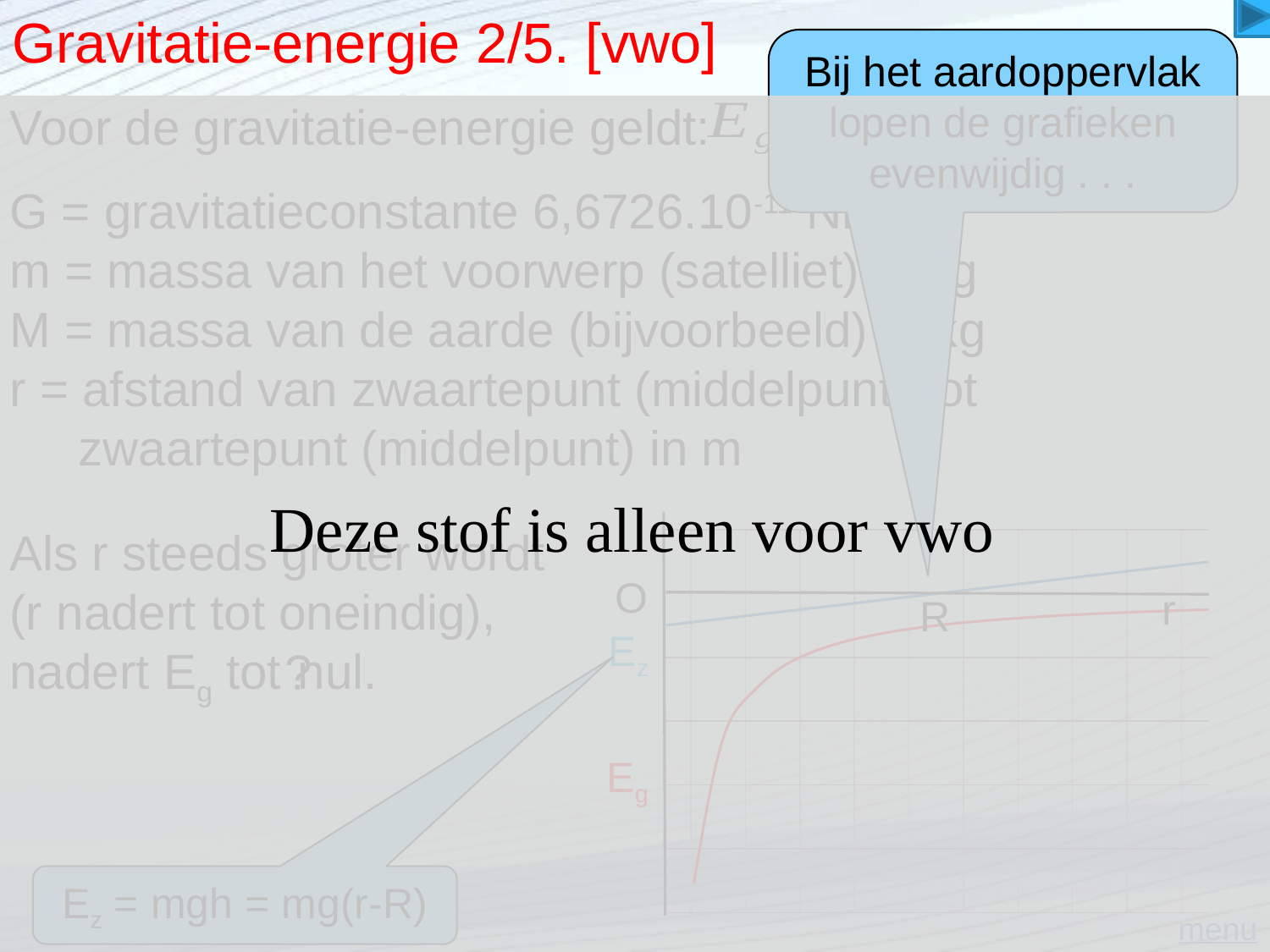
How many curves are plotted in the graph? 2 What is the label on the horizontal axis of the graph? r At large values of r, which curve lies higher, E_z or E_g? E_z Does the E_z line rise or fall as r increases? rise What kind of chart is shown in the lower right of the slide? line chart Which of the two plotted curves is a straight line, E_z or E_g? E_z Which curve in the graph is drawn in red, E_z or E_g? E_g Does the E_g curve rise or fall as r increases? rise